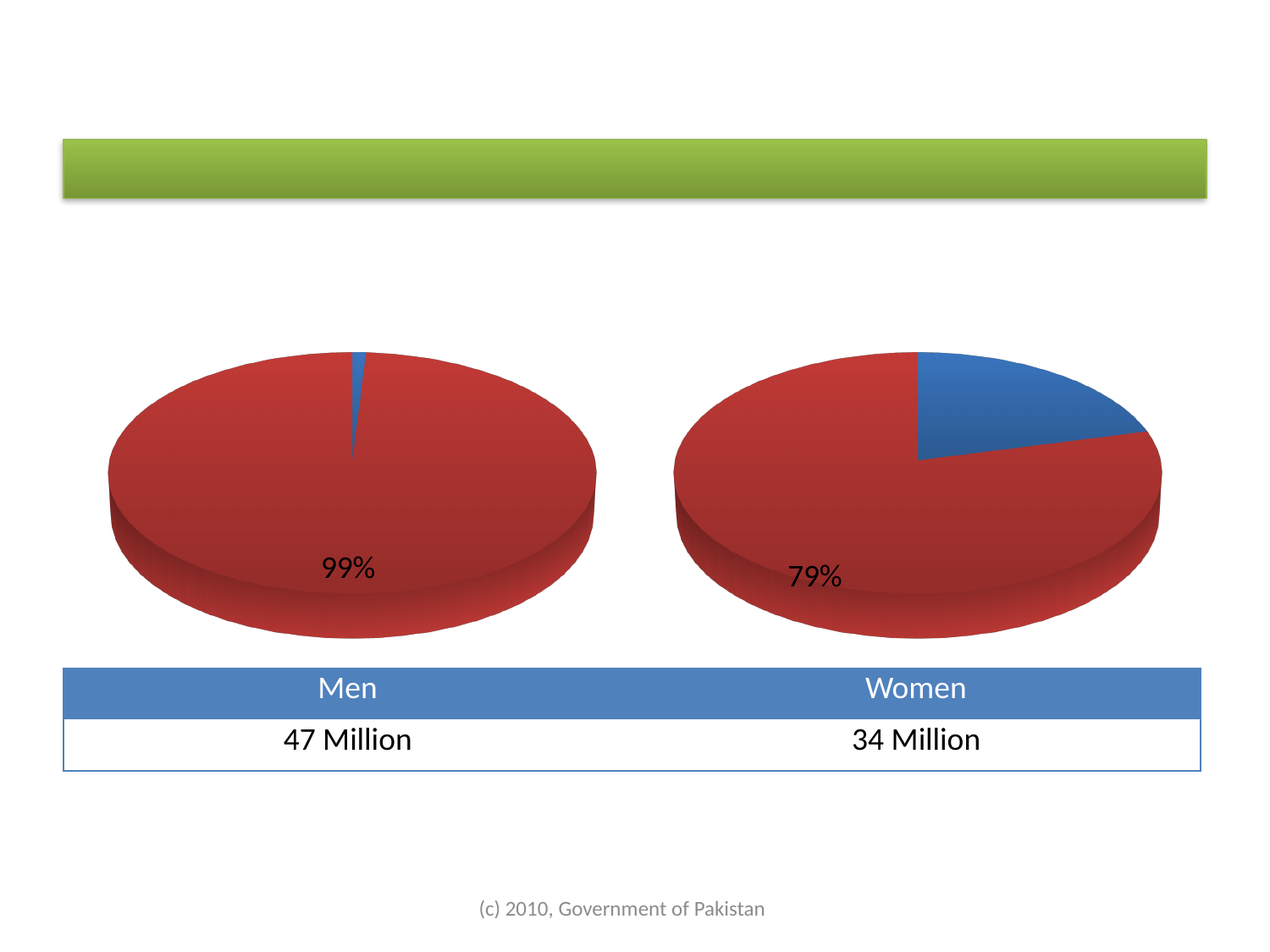
In the right pie chart (Women), what percentage is shown for the red slice? 79% How many pie charts are on the slide? 2 What kind of charts are shown on the slide? Pie charts What value is listed under Women in the table below the pie charts? 34 Million In the Men pie chart, which slice is smaller, the red one or the blue one? Blue In the Women pie chart, which slice is larger, the red one or the blue one? Red What colour is the largest slice in both pie charts? Red What is the difference in percentage points between the red slice in the Men pie chart (99%) and the red slice in the Women pie chart (79%)? 20 percentage points How many slices does the Women pie chart have? 2 In the left pie chart (Men), what percentage is shown for the red slice? 99% What value is listed under Men in the table below the pie charts? 47 Million Which pie chart has the larger red slice, the Men chart or the Women chart? Men